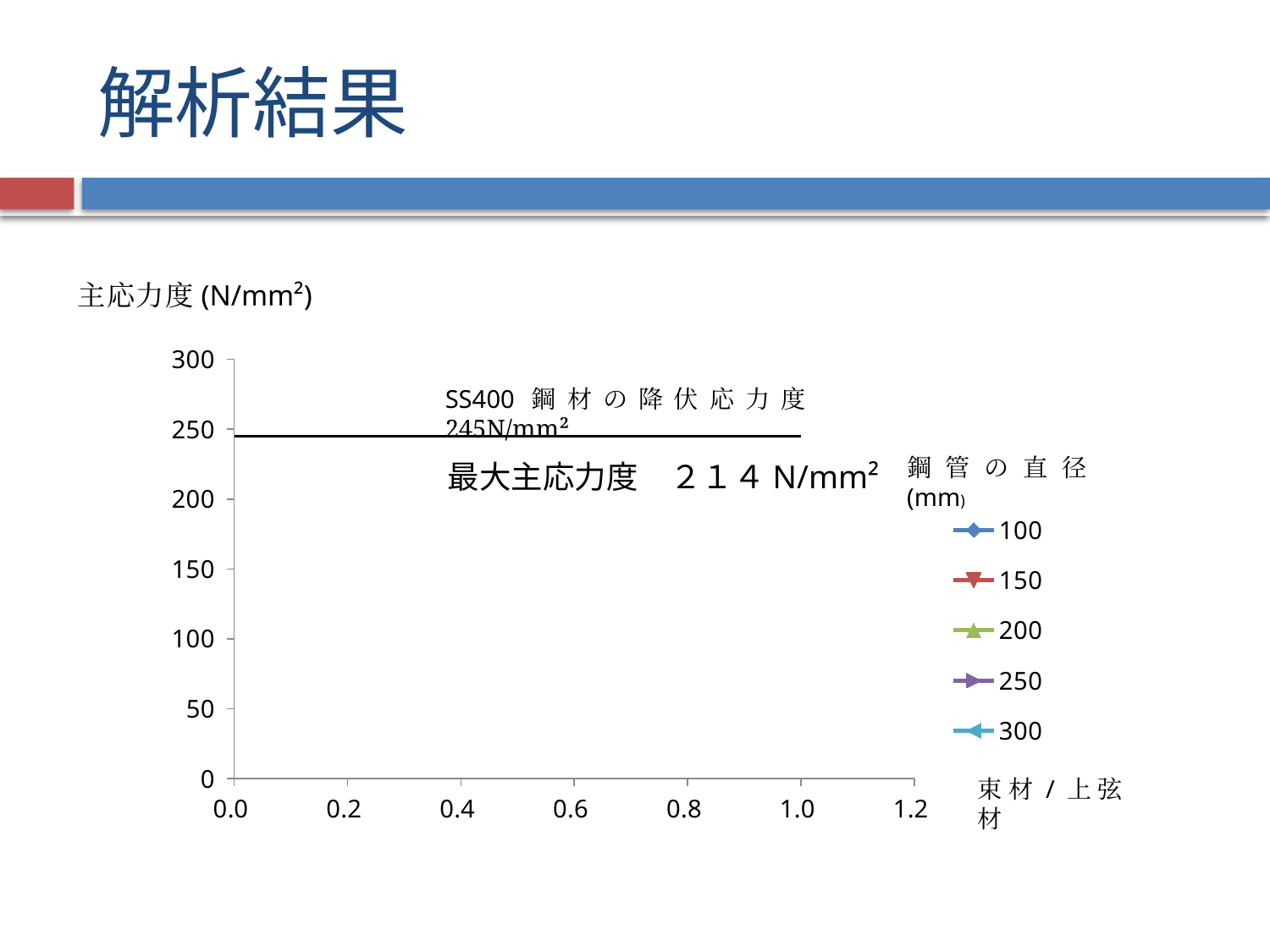
What is the highest value shown on the y axis? 300 What is the title of the legend on the chart? 鋼管の直径 (mm) What value does the horizontal line labelled SS400 鋼材の降伏応力度 represent? 245N/mm² Is the SS400 yield stress line drawn at a value greater or less than 200 on the y axis? greater Which is larger, the SS400 yield stress or the stated maximum principal stress? SS400 yield stress Is the SS400 yield stress line drawn at a value greater or less than 250 on the y axis? less What is the maximum principal stress (最大主応力度) stated on the chart? 214 N/mm² What is the difference between the SS400 yield stress (245N/mm²) and the maximum principal stress (214 N/mm²)? 31 N/mm² What are the legend entries listed on the chart? 100, 150, 200, 250, 300 What kind of chart is shown on the slide? line chart How many series does the chart legend list? 5